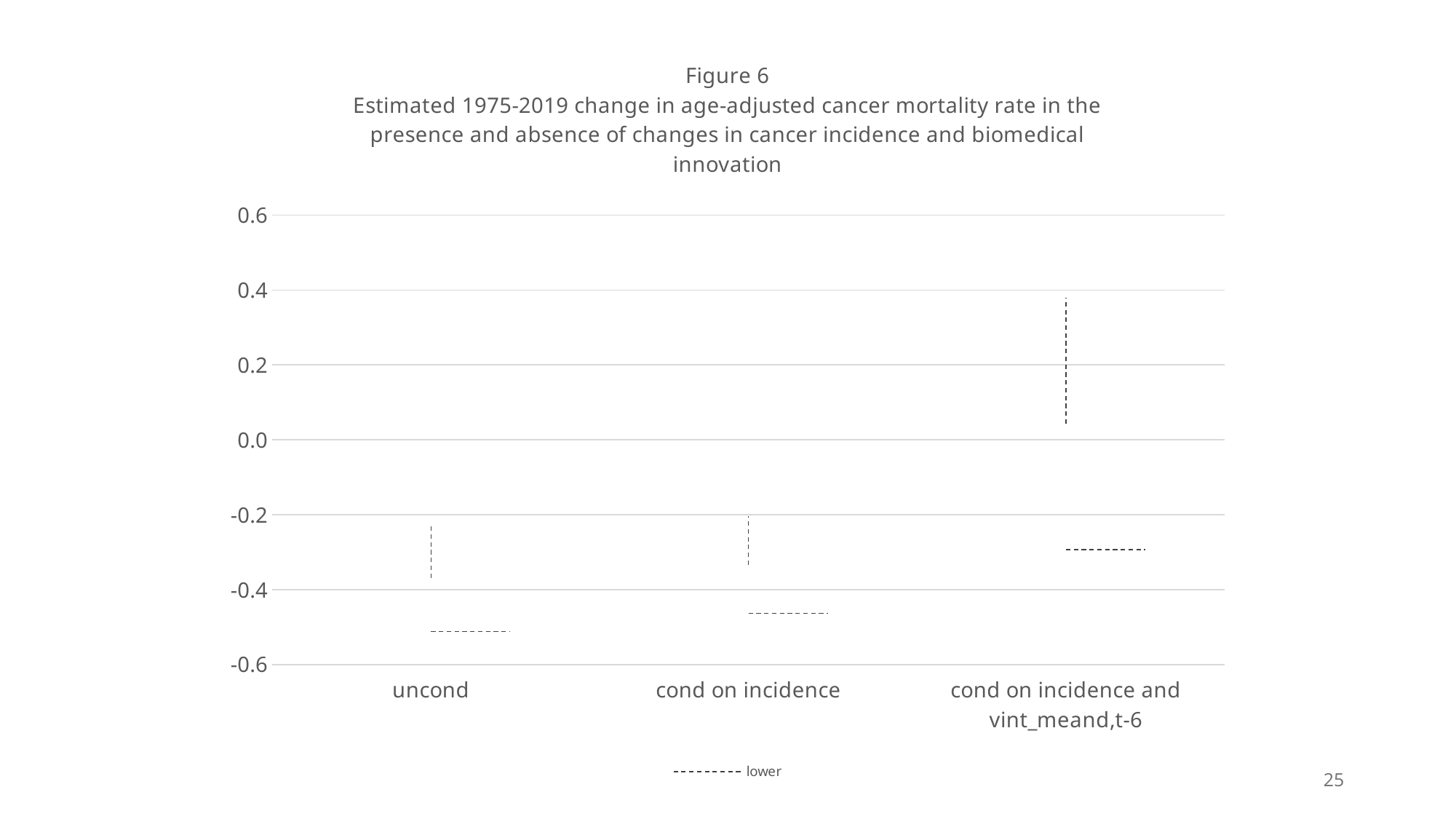
Which category has the highest 'lower' value? cond on incidence and vint_meand,t-6 Is the 'lower' value for cond on incidence greater or less than -0.4? less What is the name of the series listed in the chart's legend? lower Is the 'lower' value for cond on incidence and vint_meand,t-6 greater or less than -0.2? less Is the 'lower' value for uncond greater or less than -0.4? less How many categories are shown on the x axis of the chart? 3 How many series does the chart's legend list? 1 Which has the larger 'lower' value: uncond or cond on incidence and vint_meand,t-6? cond on incidence and vint_meand,t-6 Do the 'lower' values rise or fall moving left to right along the x axis? rise What is the figure number given in the chart title? Figure 6 Which category has the lowest 'lower' value? uncond